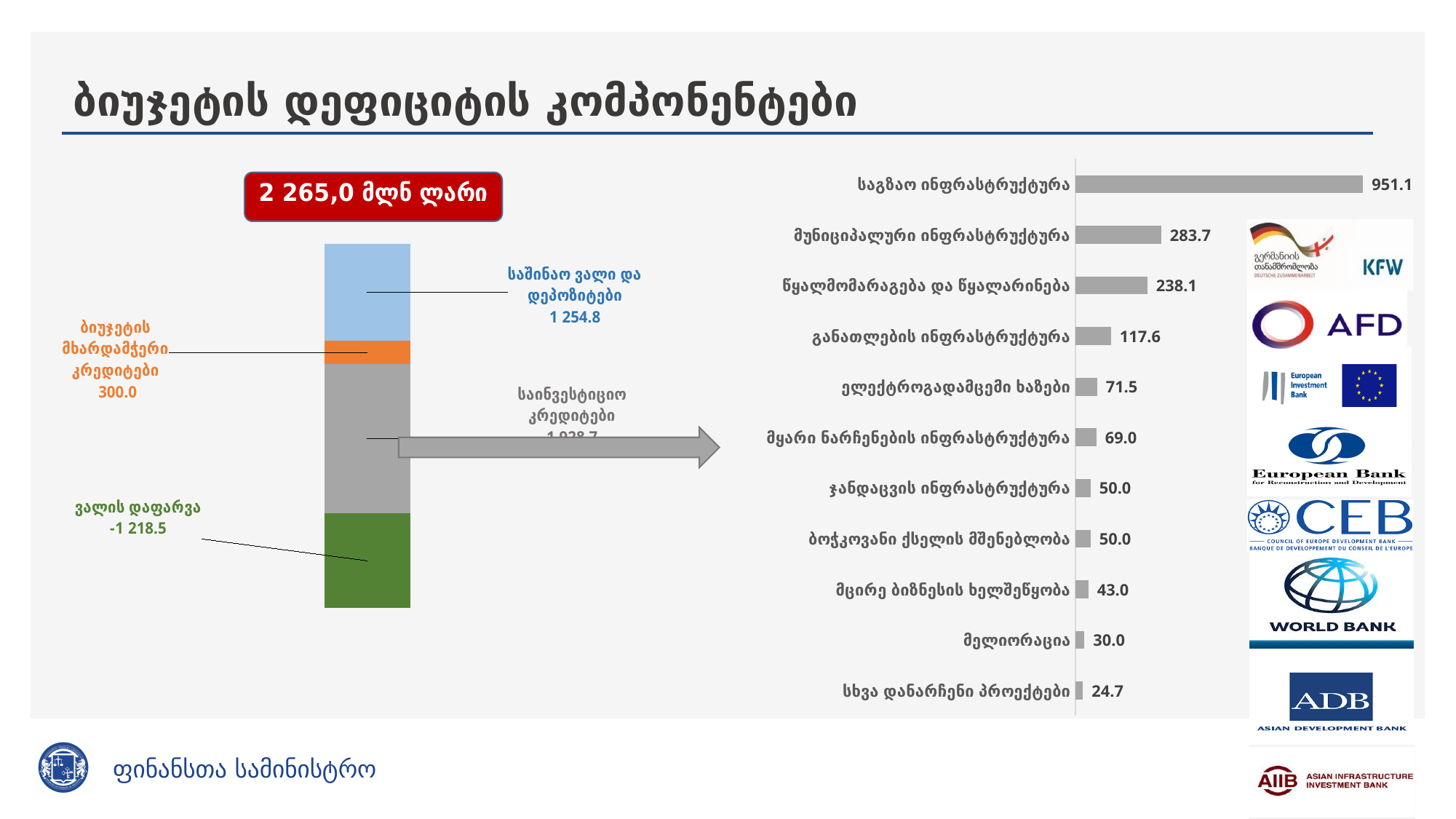
On the horizontal bar chart on the right, what is the value for განათლების ინფრასტრუქტურა? 117.6 On the horizontal bar chart on the right, what is the value for საგზაო ინფრასტრუქტურა? 951.1 What kind of chart is shown on the right side of the slide? Bar chart How many categories are shown on the horizontal bar chart on the right? 11 On the horizontal bar chart on the right, which category has the lowest value? სხვა დანარჩენი პროექტები On the horizontal bar chart on the right, what is the difference between საგზაო ინფრასტრუქტურა and მუნიციპალური ინფრასტრუქტურა? 667.4 On the horizontal bar chart on the right, what is the value for მუნიციპალური ინფრასტრუქტურა? 283.7 On the stacked bar chart on the left, what is the value for ვალის დაფარვა? -1 218.5 On the stacked bar chart on the left, what total is shown in the red box above the bar? 2 265,0 მლნ ლარი On the horizontal bar chart on the right, which category has the highest value? საგზაო ინფრასტრუქტურა On the horizontal bar chart on the right, which is larger: წყალმომარაგება და წყალარინება or ელექტროგადამცემი ხაზები? წყალმომარაგება და წყალარინება On the stacked bar chart on the left, what is the value for საშინაო ვალი და დეპოზიტები? 1 254.8